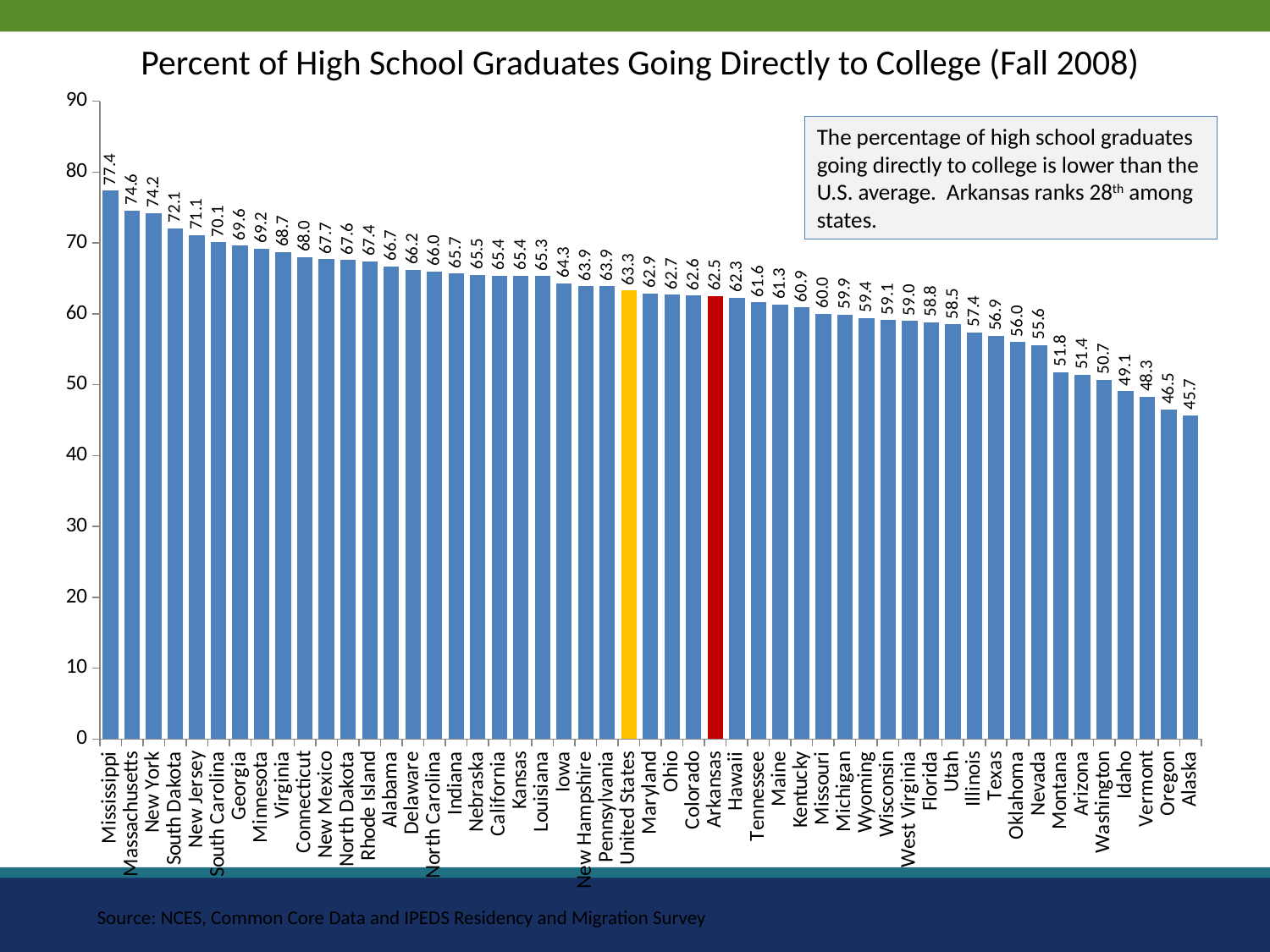
What is the difference between the values for Mississippi and Alaska? 31.7 Which has a larger value, Georgia or Florida? Georgia What is the value for Arkansas? 62.5 Do the values rise or fall moving from left to right along the x axis? Fall Which category has the lowest value? Alaska Is the value for Montana greater or less than 60? less What is the difference between the values for United States and Arkansas? 0.8 Which category has the highest value? Mississippi Which bar is coloured red? Arkansas What is the value for Texas? 56.9 What type of chart is shown on the slide? Bar chart What is the value for United States? 63.3